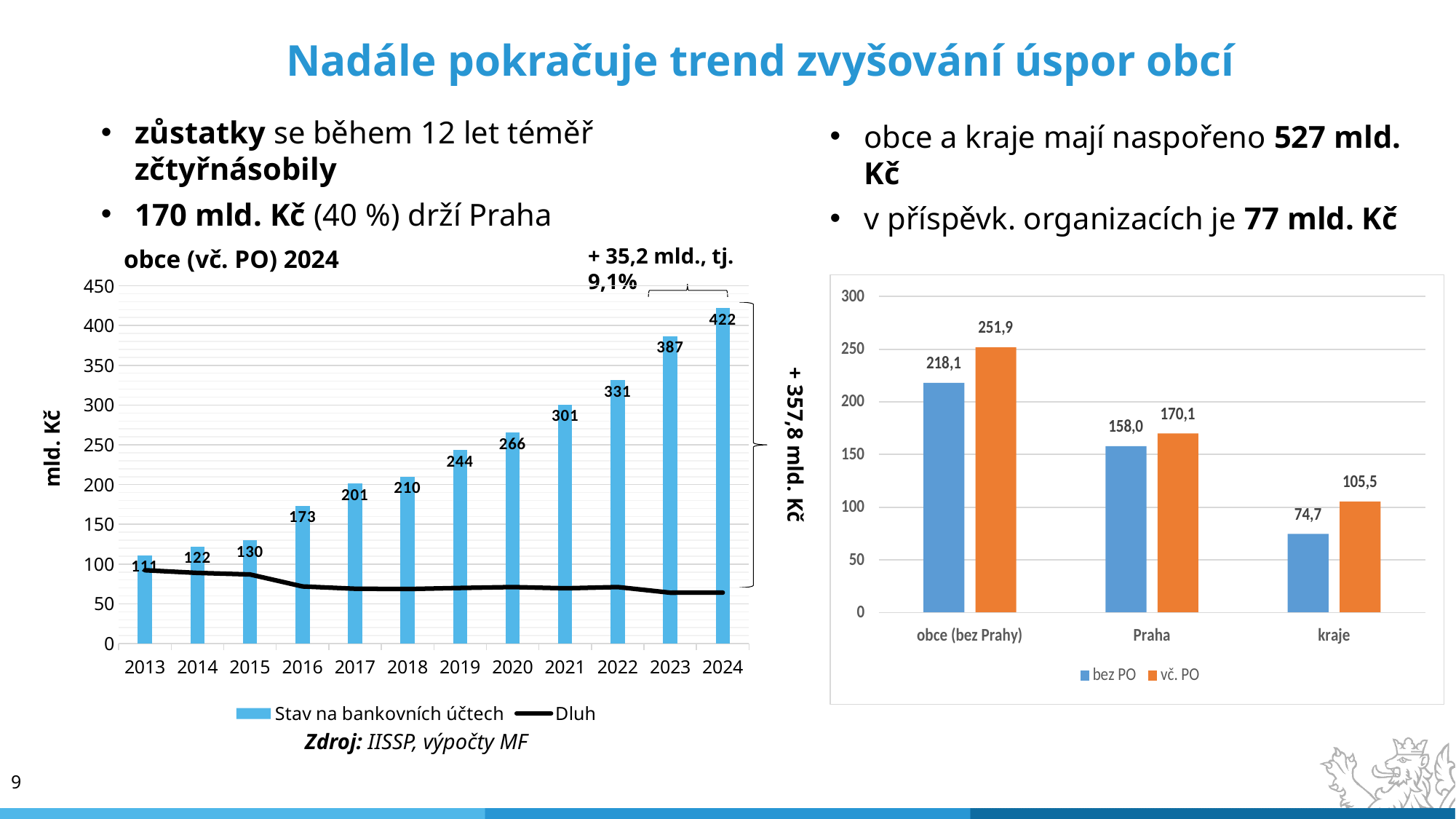
In the right chart, which category has the highest 'vč. PO' value? obce (bez Prahy) In the left chart titled 'obce (vč. PO) 2024', which year has the lowest bar value? 2013 In the left chart titled 'obce (vč. PO) 2024', is the 'Dluh' value for 2024 greater or less than 100? less In the right chart, what is the 'vč. PO' value for Praha? 170,1 In the left chart titled 'obce (vč. PO) 2024', how many years are shown on the x axis? 12 In the left chart titled 'obce (vč. PO) 2024', what is the value of 'Stav na bankovních účtech' for 2018? 210 In the left chart titled 'obce (vč. PO) 2024', what is the value of 'Stav na bankovních účtech' for 2024? 422 In the left chart titled 'obce (vč. PO) 2024', what is the difference between the bar values for 2024 and 2023? 35 In the right chart, what is the difference between the 'vč. PO' and 'bez PO' values for kraje? 30,8 In the left chart titled 'obce (vč. PO) 2024', do the bar values rise or fall from 2013 to 2024? rise In the left chart titled 'obce (vč. PO) 2024', how many series does the legend list? 2 In the right chart, what is the 'bez PO' value for kraje? 74,7